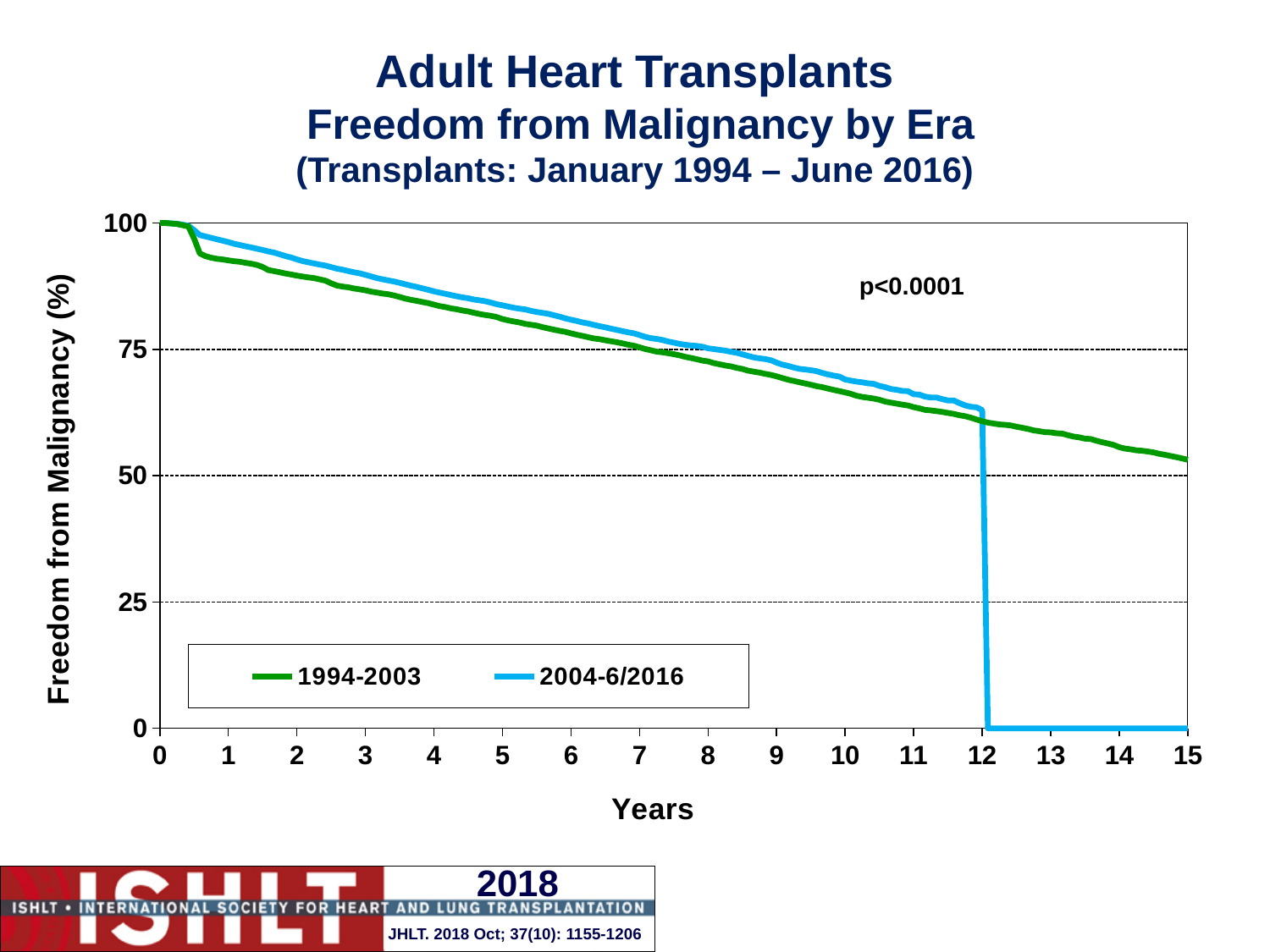
Is the value for the 1994-2003 series at 15 years greater or less than 50? greater Is the value for the 2004-6/2016 series at 10 years greater or less than 75? less At 5 years, which series has the higher freedom from malignancy, 1994-2003 or 2004-6/2016? 2004-6/2016 How many series does the legend list? 2 At 14 years, which series has the higher value, 1994-2003 or 2004-6/2016? 1994-2003 Is the value for the 2004-6/2016 series at 3 years greater or less than 75? greater What kind of chart is shown on the slide? Line chart Does freedom from malignancy for the 1994-2003 era rise or fall as years increase? Fall What p-value is printed on the chart? p<0.0001 Which two eras are listed in the legend? 1994-2003 and 2004-6/2016